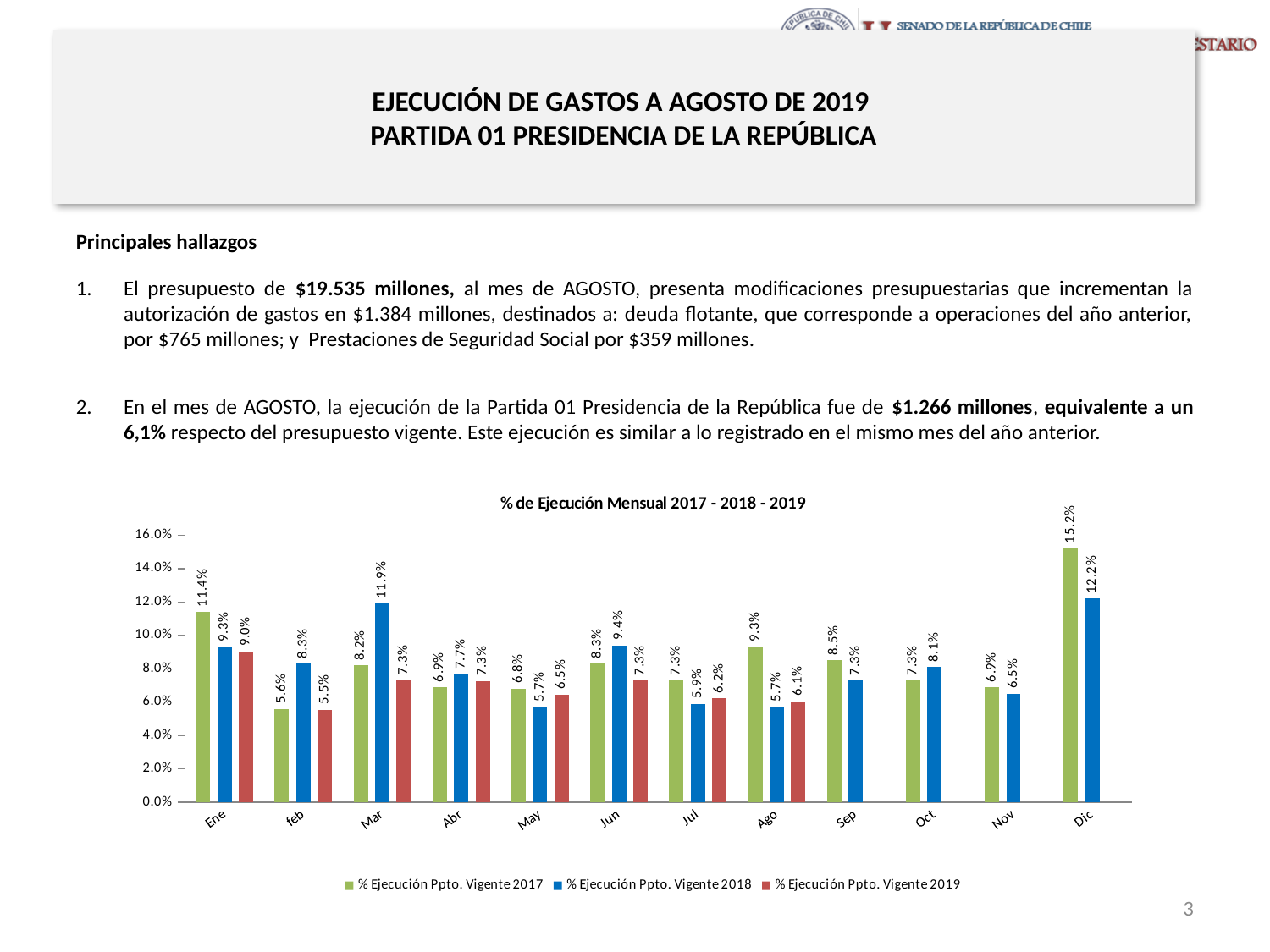
What is the difference between the 2017 and 2018 values for Ene? 2.1% What is the title of the chart on the slide? % de Ejecución Mensual 2017 - 2018 - 2019 How many series does the legend list in the chart '% de Ejecución Mensual 2017 - 2018 - 2019'? 3 Is the value of '% Ejecución Ppto. Vigente 2017' for Ene greater or less than 10.0%? greater Which month has the lowest value for '% Ejecución Ppto. Vigente 2019'? feb How many months are shown on the x axis of the chart? 12 What type of chart is shown on the slide? bar chart What is the value of '% Ejecución Ppto. Vigente 2018' for Mar? 11.9% Which is larger for Jun: the 2017 value or the 2018 value? 2018 (9.4%) What is the value of '% Ejecución Ppto. Vigente 2017' for Dic? 15.2% What is the value of '% Ejecución Ppto. Vigente 2019' for Ago? 6.1% Which month has the highest value for '% Ejecución Ppto. Vigente 2018'? Dic